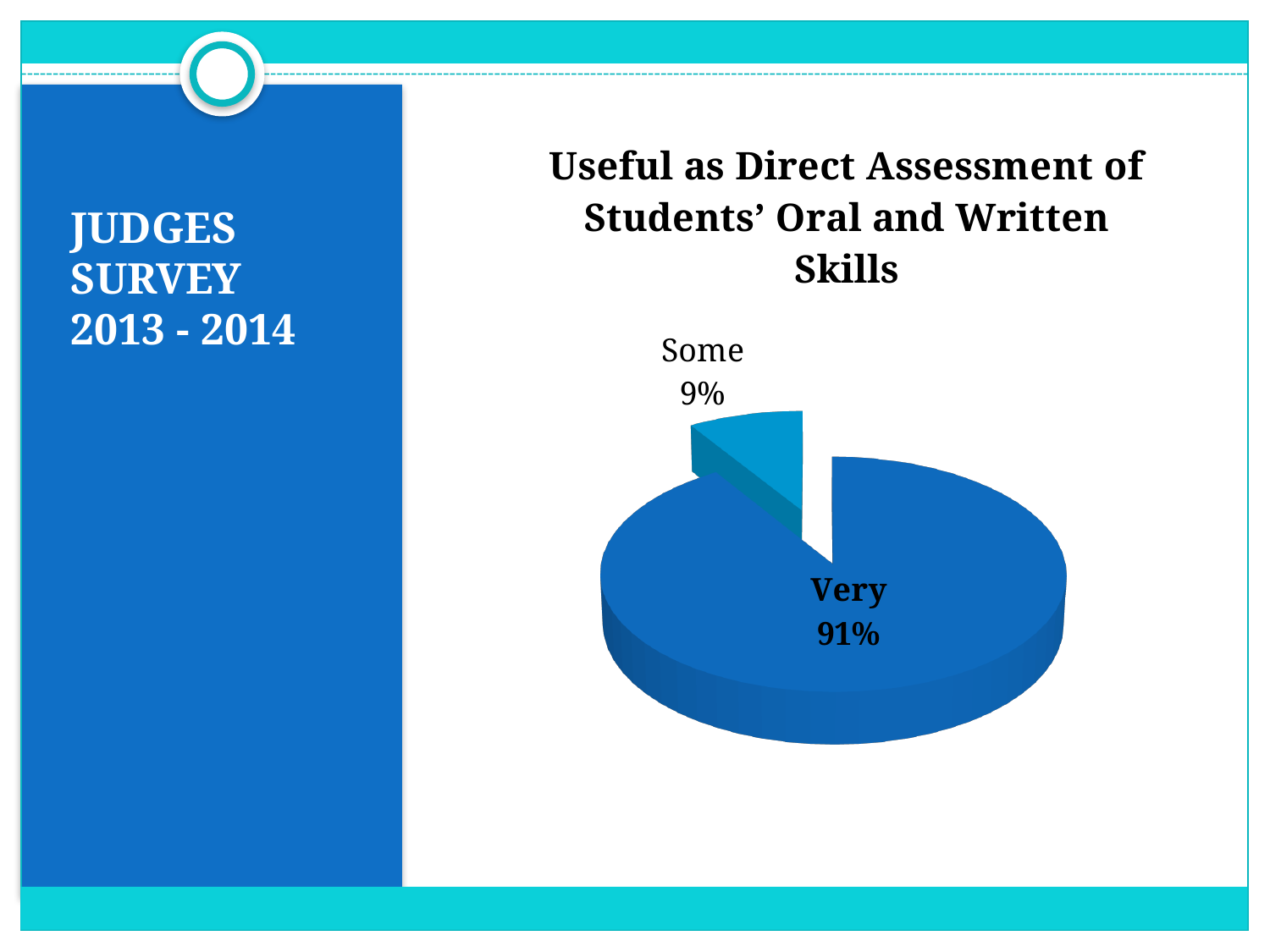
What is the difference in percentage points between the "Very" and "Some" slices? 82 Which slice of the pie is the smallest? Some How many slices does the pie chart have? 2 Which is larger, the "Very" slice or the "Some" slice? Very Which slice of the pie is the largest? Very What share of the pie does the "Very" slice represent? 91% What is the total of the two slice percentages shown on the pie chart? 100% What is the title of the chart? Useful as Direct Assessment of Students' Oral and Written Skills What kind of chart is shown on the slide? Pie chart What share of the pie does the "Some" slice represent? 9%